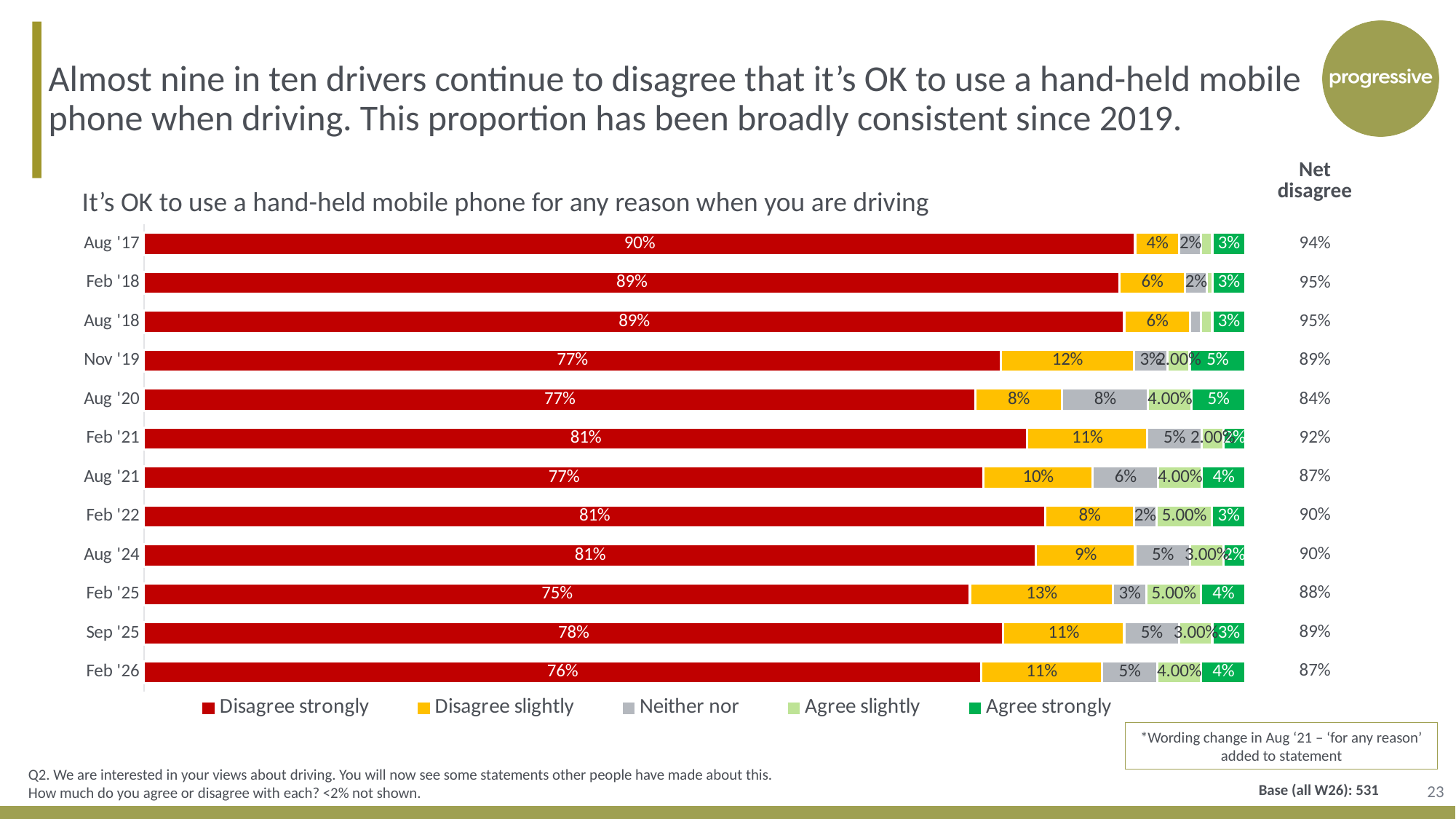
What is the difference between the Disagree strongly values for Aug '17 and Feb '26? 14 percentage points Which has the larger Disagree strongly value, Feb '21 or Aug '21? Feb '21 What kind of chart is shown on the slide? Stacked bar chart Which colour represents Disagree strongly in the legend? Red How many series does the legend list? 5 What is the Disagree strongly value for Aug '17? 90% What is the Disagree slightly value for Feb '25? 13% What is the Net disagree figure shown for Feb '26? 87% What is the Neither nor value for Aug '20? 8% Which wave has the lowest Disagree strongly value? Feb '25 How many survey waves are shown on the chart? 12 Which wave has the highest Disagree strongly value? Aug '17